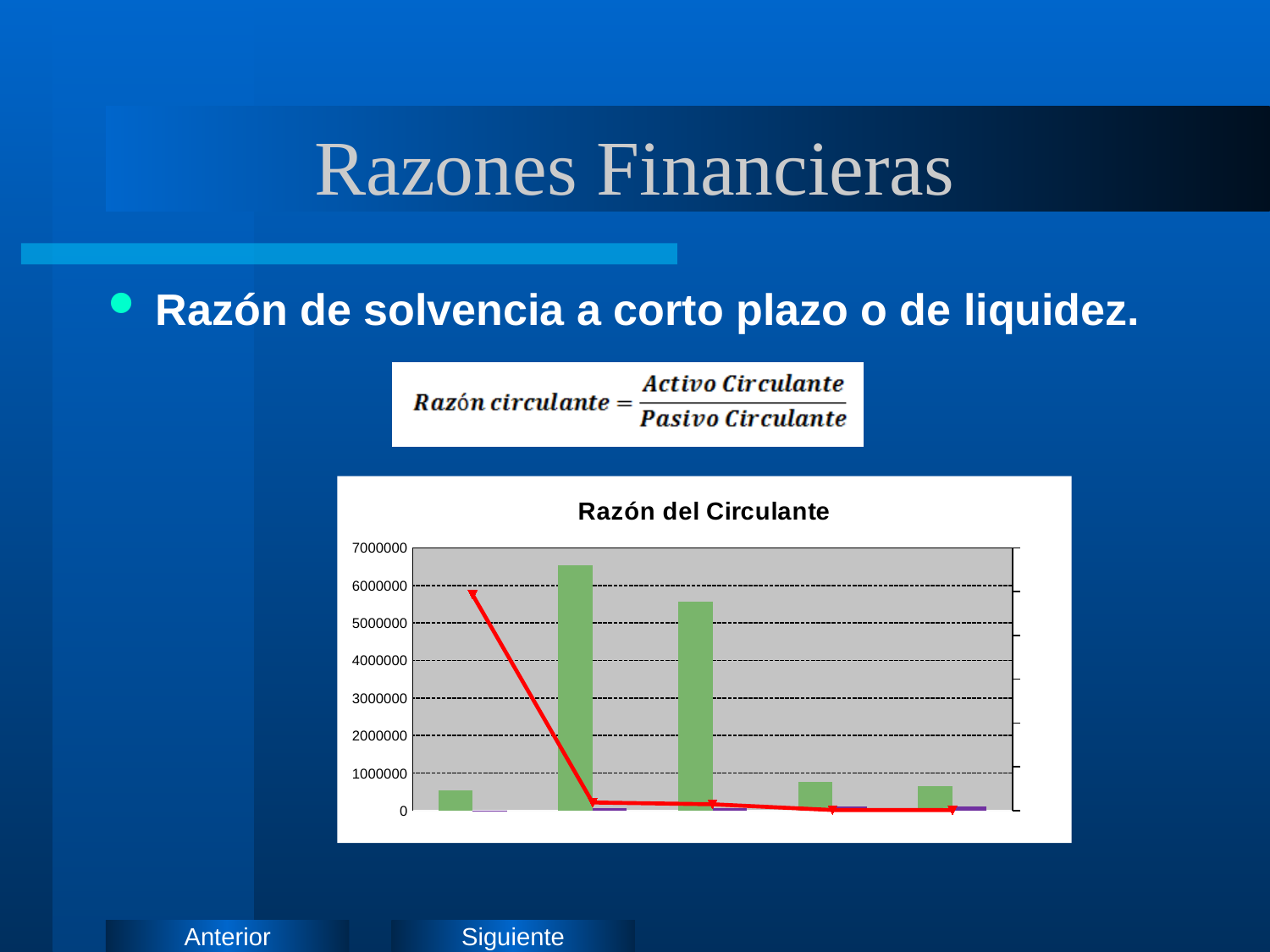
In the "Razón del Circulante" chart, is the value of the green bar in the third group greater or less than 5000000? greater What is the highest value labelled on the left vertical axis of the "Razón del Circulante" chart? 7000000 What is the title of the chart on the slide? Razón del Circulante In the "Razón del Circulante" chart, is the value of the green bar in the second group greater or less than 6000000? greater What kind of chart is shown under the title "Razón del Circulante"? bar chart with a line In the "Razón del Circulante" chart, is the value of the green bar in the first group greater or less than 1000000? less How many groups of bars are plotted along the x axis of the "Razón del Circulante" chart? 5 In the "Razón del Circulante" chart, is the green bar in the second group taller or shorter than the green bar in the third group? taller In the "Razón del Circulante" chart, does the red line generally rise or fall from left to right? fall In the "Razón del Circulante" chart, which group of bars has the tallest green bar? the second group In the "Razón del Circulante" chart, which group of bars has the shortest green bar? the first group